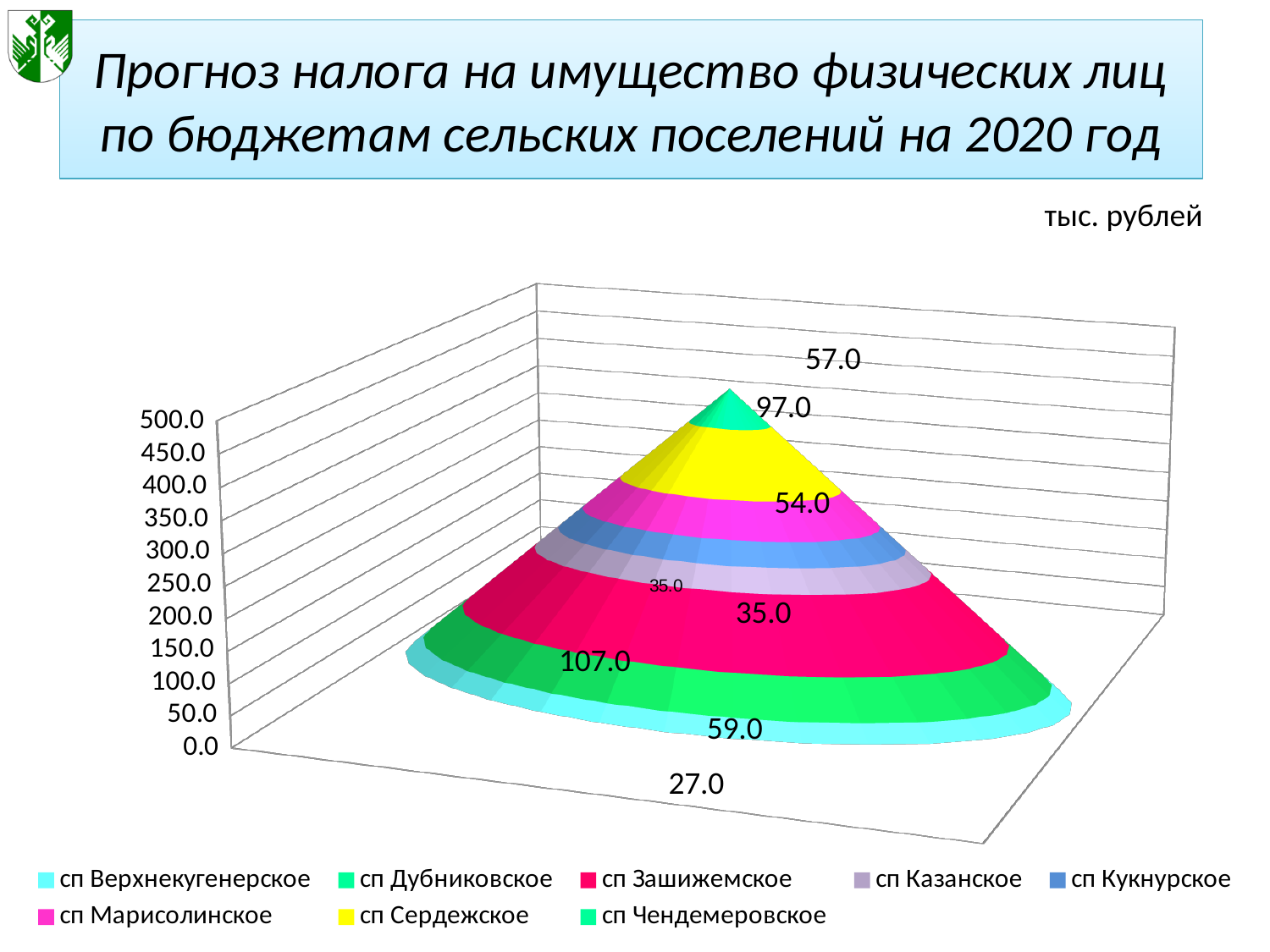
What is the value for сп Зашижемское? 107.0 What is the value for сп Сердежское? 97.0 What is the value for сп Дубниковское? 59.0 What is the value for сп Верхнекугенерское? 27.0 Which is larger, the value for сп Дубниковское or сп Марисолинское? сп Дубниковское In what units are the values on the chart given? тыс. рублей Which settlement has the lowest value? сп Верхнекугенерское What is the difference between the values for сп Зашижемское and сп Сердежское? 10.0 What is the value for сп Марисолинское? 54.0 What is the title of the chart on the slide? Прогноз налога на имущество физических лиц по бюджетам сельских поселений на 2020 год Which settlement has the highest value? сп Зашижемское How many series does the legend list? 8